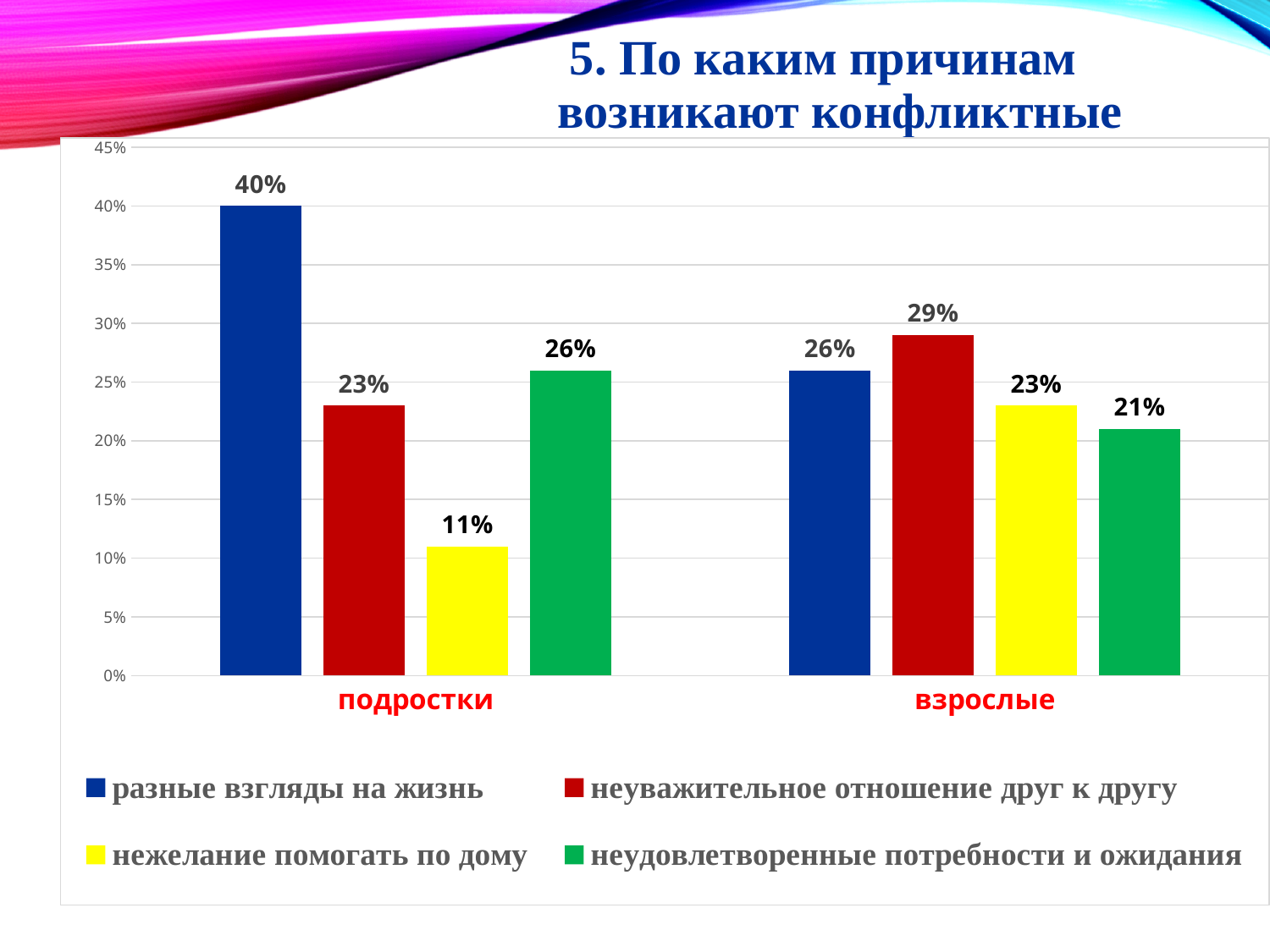
What is the value for "неуважительное отношение друг к другу" in the "взрослые" group? 29% How many series does the legend list? 4 Which series has the highest value in the "подростки" group? разные взгляды на жизнь Which series has the lowest value in the "взрослые" group? неудовлетворенные потребности и ожидания What colour represents "неудовлетворенные потребности и ожидания" in the legend? green What is the difference between the "разные взгляды на жизнь" values for "подростки" and "взрослые"? 14% What kind of chart is shown on the slide? bar chart What is the value for "разные взгляды на жизнь" in the "подростки" group? 40% What is the value for "нежелание помогать по дому" in the "подростки" group? 11% Which group has the larger value for "нежелание помогать по дому": "подростки" or "взрослые"? взрослые How many category groups are shown on the x axis? 2 What is the value for "неудовлетворенные потребности и ожидания" in the "взрослые" group? 21%